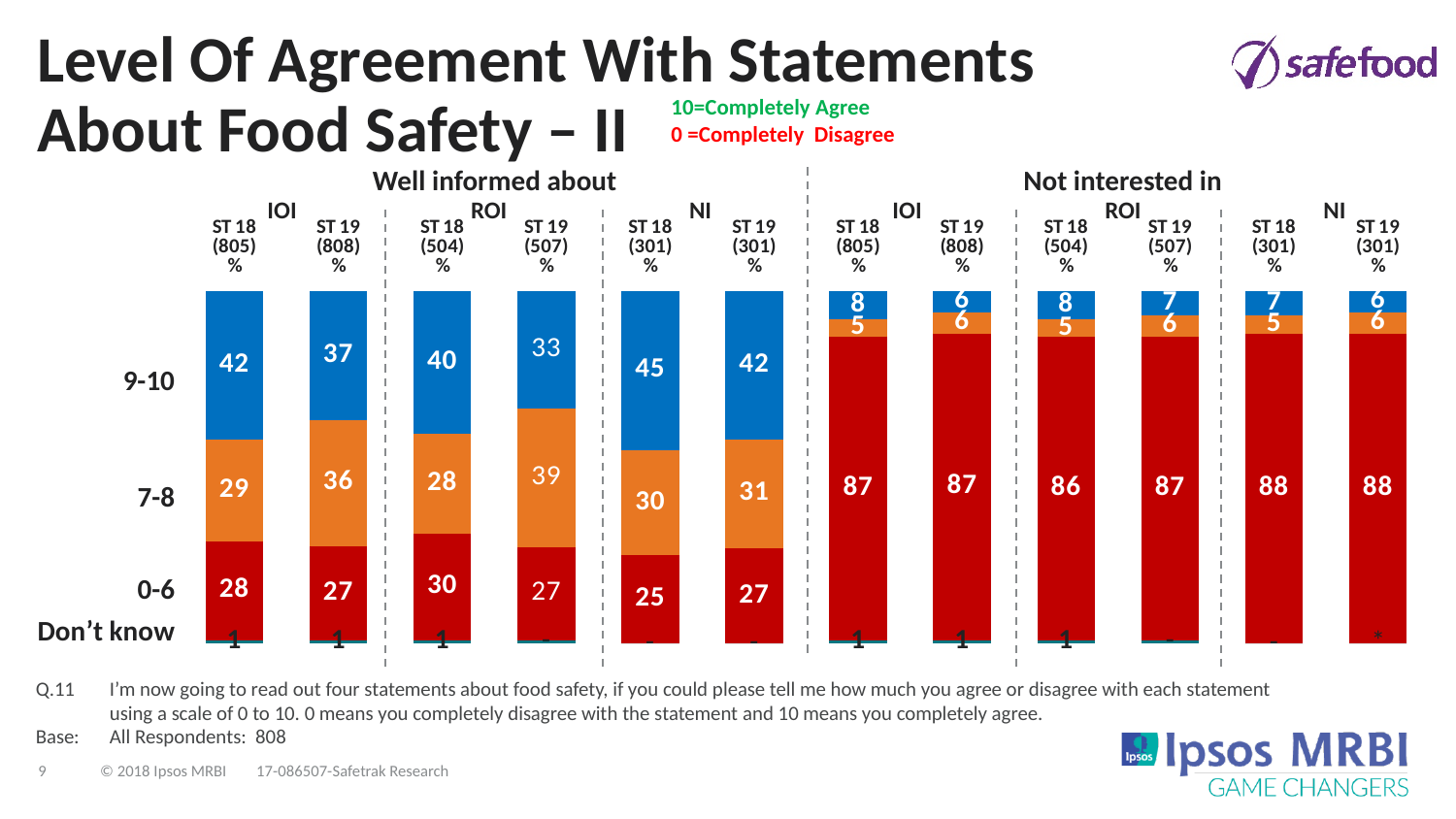
How many bars are shown in the 'Well informed about' chart? 6 In the 'Not interested in' chart, what is the 0-6 value for NI ST 19? 88 What is the base (number of respondents) shown for ST 19 IOI? 808 In the 'Well informed about' chart, what is the difference between the 9-10 values for IOI ST 18 and IOI ST 19? 5 In the 'Well informed about' chart, what is the 0-6 value for NI ST 18? 25 In the 'Well informed about' chart, which bar has the lowest 9-10 value? ROI ST 19 What type of chart is used on this slide? Stacked bar chart In the 'Not interested in' chart, which is larger: the 0-6 value for ROI ST 18 or for NI ST 18? NI ST 18 In the 'Not interested in' chart, what is the 9-10 value for IOI ST 18? 8 In the 'Well informed about' chart, which bar has the highest 9-10 value? NI ST 18 In the 'Well informed about' chart, what is the 7-8 value for ROI ST 19? 39 In the 'Well informed about' chart, what percentage of IOI ST 18 respondents gave a 9-10 rating? 42